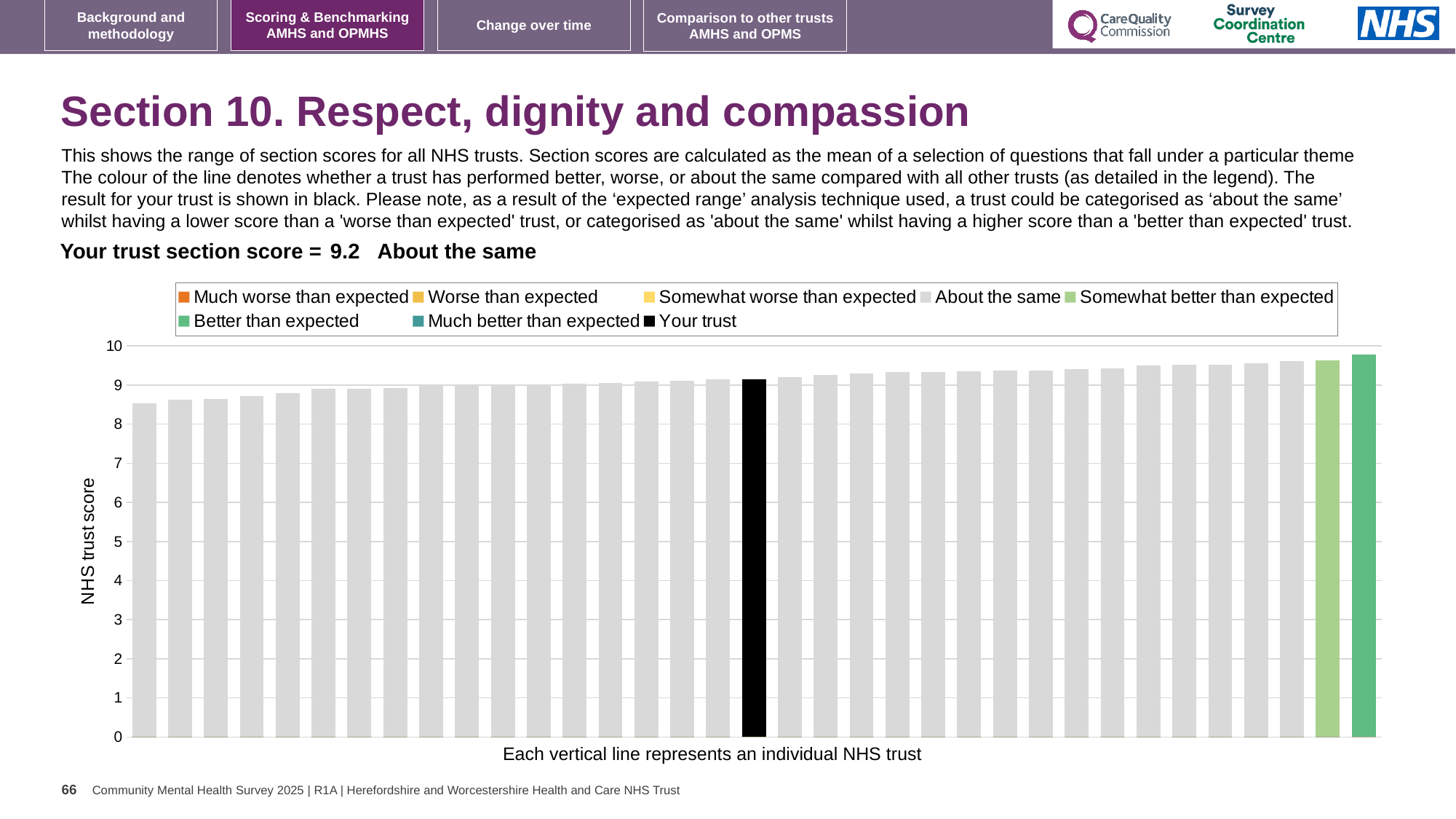
How many entries does the chart legend list? 8 Which is larger, the leftmost bar or the rightmost bar? the rightmost bar What colour is the bar representing your trust? Black Is the value of the black 'Your trust' bar greater or less than 8? greater Do the bar values rise or fall from left to right along the x axis? rise Which performance category is your trust placed in for this section? About the same What is the section score for your trust shown on the slide? 9.2 What is the label on the vertical axis of the chart? NHS trust score Which legend category does the tallest bar belong to? Better than expected What kind of chart is shown on the slide? Bar chart Is the value of the rightmost bar greater or less than 9? greater Is the value of the leftmost bar greater or less than 8? greater